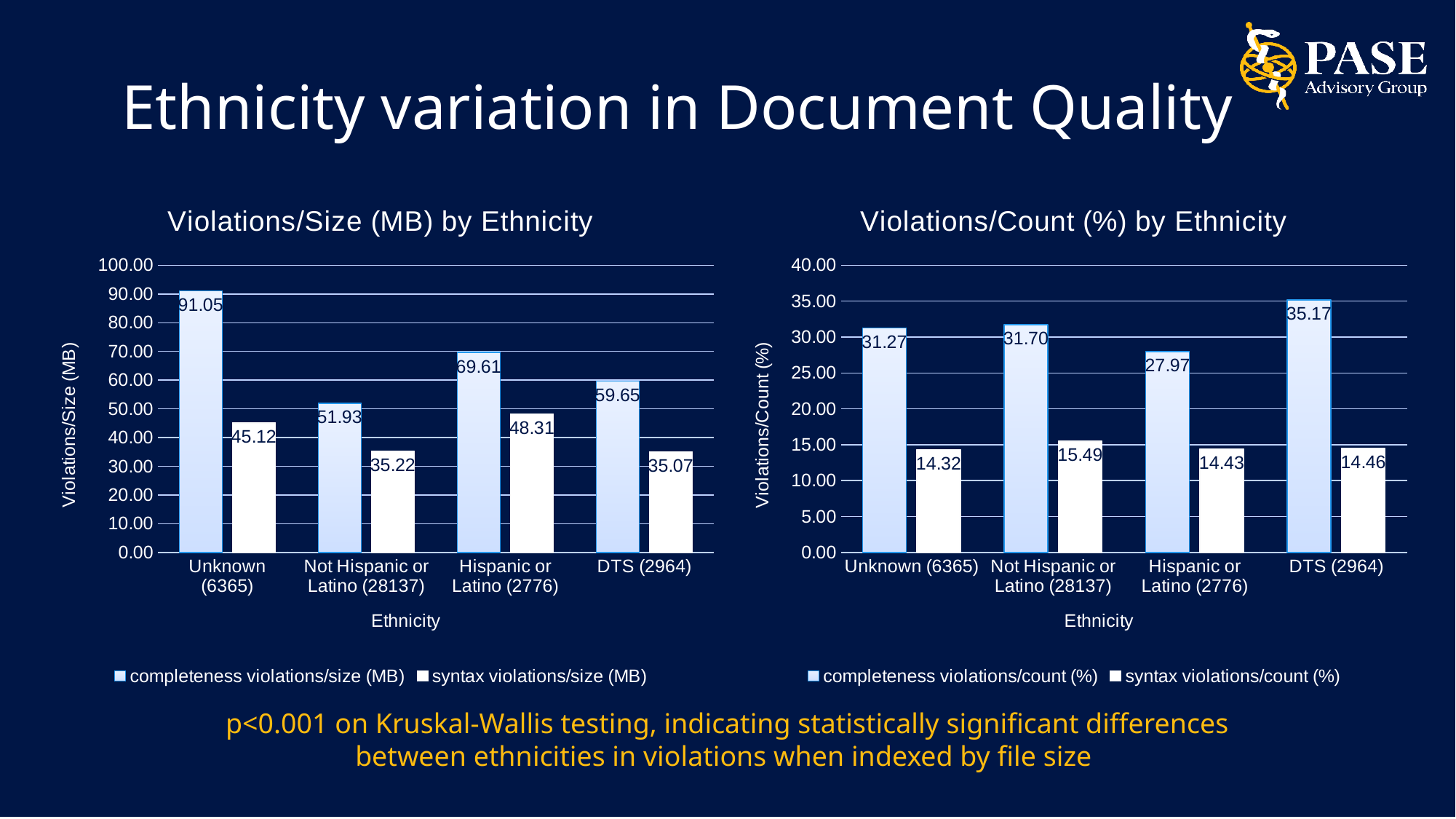
In the 'Violations/Size (MB) by Ethnicity' chart, which ethnicity has the highest completeness violations/size (MB)? Unknown (6365) In the 'Violations/Size (MB) by Ethnicity' chart, what is the difference between the completeness and syntax violations/size (MB) values for Unknown (6365)? 45.93 In the 'Violations/Size (MB) by Ethnicity' chart, what is the syntax violations/size (MB) value for Hispanic or Latino (2776)? 48.31 What type of chart is the 'Violations/Size (MB) by Ethnicity' chart? Bar chart In the 'Violations/Count (%) by Ethnicity' chart, which ethnicity has the lowest completeness violations/count (%)? Hispanic or Latino (2776) In the 'Violations/Size (MB) by Ethnicity' chart, which ethnicity has the lowest syntax violations/size (MB)? DTS (2964) In the 'Violations/Count (%) by Ethnicity' chart, is the completeness violations/count (%) value for DTS (2964) larger than that for Not Hispanic or Latino (28137)? Yes In the 'Violations/Count (%) by Ethnicity' chart, what is the syntax violations/count (%) value for Not Hispanic or Latino (28137)? 15.49 How many ethnicity categories are shown in the 'Violations/Size (MB) by Ethnicity' chart? 4 How many series does the legend of the 'Violations/Count (%) by Ethnicity' chart list? 2 In the 'Violations/Size (MB) by Ethnicity' chart, what is the completeness violations/size (MB) value for Unknown (6365)? 91.05 In the 'Violations/Count (%) by Ethnicity' chart, what is the completeness violations/count (%) value for DTS (2964)? 35.17